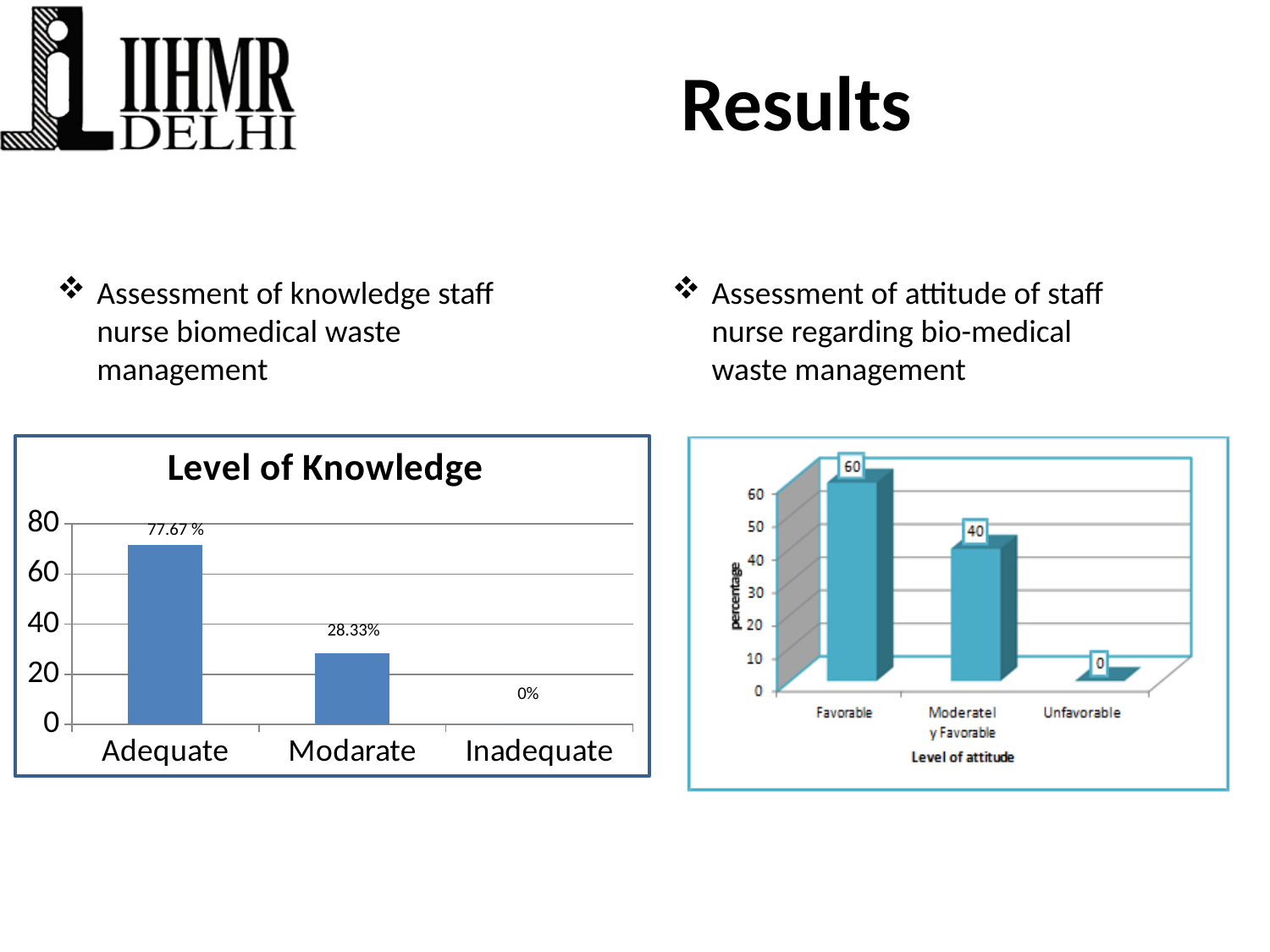
In the right-hand chart (Level of attitude), what is the value for Favorable? 60 In the right-hand chart (Level of attitude), what is the difference between the Favorable and Moderately Favorable values? 20 In the Level of Knowledge chart, how many categories are shown on the x axis? 3 In the Level of Knowledge chart, what is the value for Adequate? 77.67 % In the right-hand chart (Level of attitude), what is the value for Moderately Favorable? 40 In the right-hand chart, what is the label of the vertical axis? percentage In the Level of Knowledge chart, what is the difference between the Adequate and Modarate values? 49.34% In the Level of Knowledge chart, which category has the highest value? Adequate In the right-hand chart (Level of attitude), which category has the lowest value? Unfavorable What kind of chart is the Level of Knowledge chart? Bar chart In the Level of Knowledge chart, what is the value for Modarate? 28.33% In the Level of Knowledge chart, what is the value for Inadequate? 0%